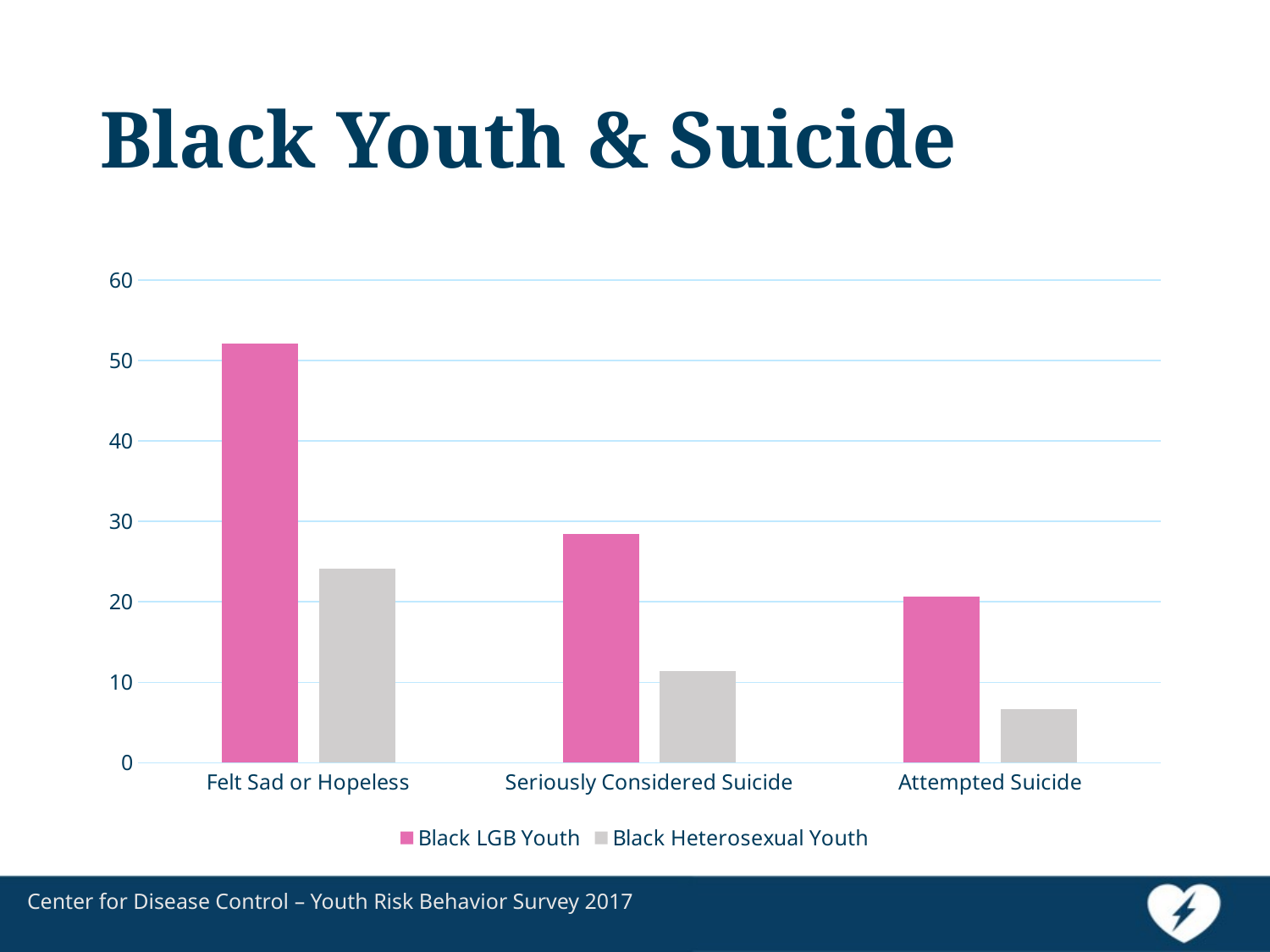
Is the value for Black Heterosexual Youth in Felt Sad or Hopeless greater or less than 30? less Which category has the lowest value for Black Heterosexual Youth? Attempted Suicide Is the value for Black Heterosexual Youth in Attempted Suicide greater or less than 10? less How many categories are shown on the x axis? 3 Do the values for Black LGB Youth rise or fall from left to right across the categories? fall For Attempted Suicide, which series has the larger value: Black LGB Youth or Black Heterosexual Youth? Black LGB Youth Which colour represents Black Heterosexual Youth in the chart? grey How many series does the legend list? 2 Is the value for Black LGB Youth in Felt Sad or Hopeless greater or less than 40? greater Which category has the highest value for Black LGB Youth? Felt Sad or Hopeless What kind of chart is shown on the slide? bar chart